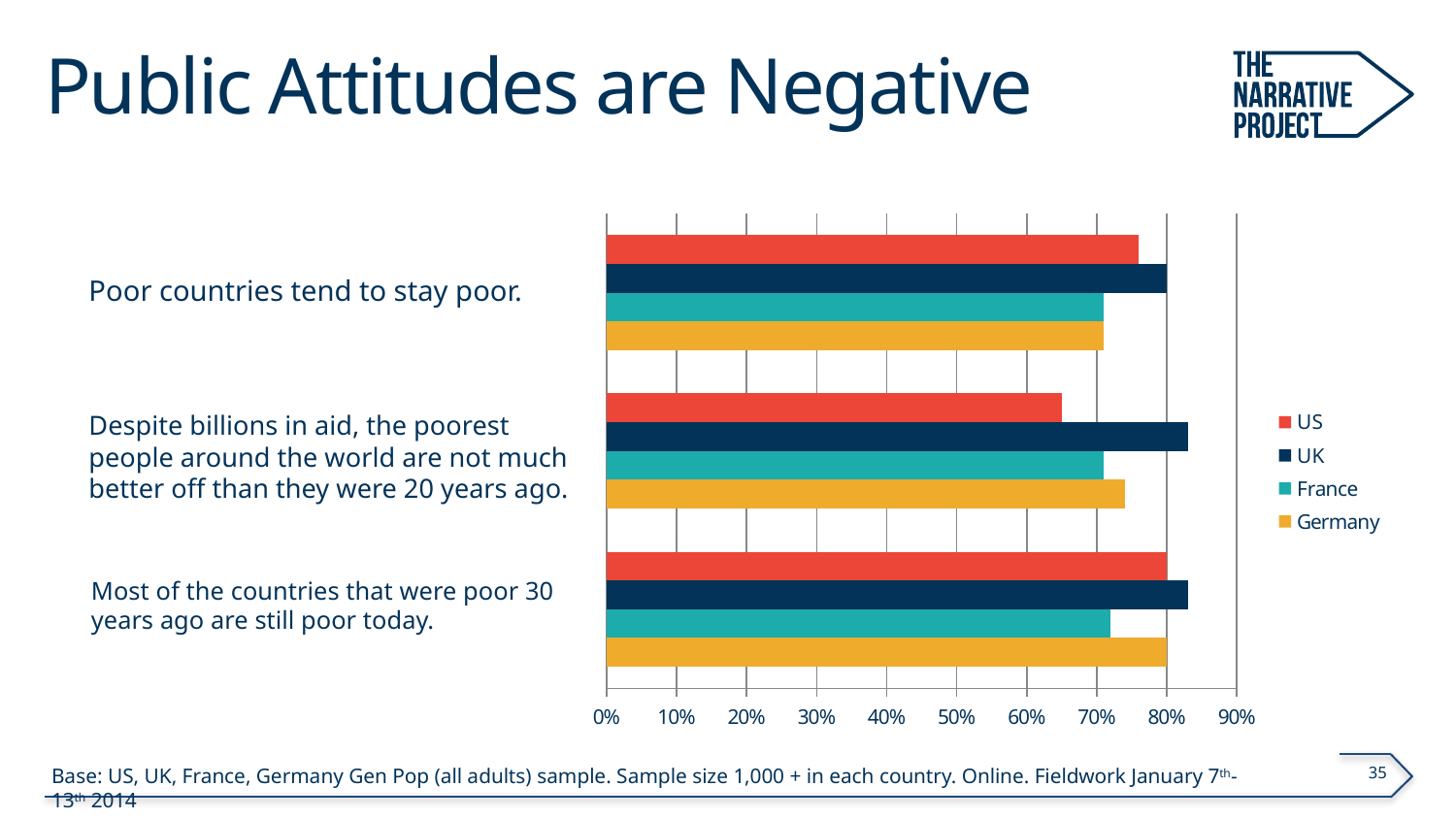
Is the value for the US on "Poor countries tend to stay poor" greater or less than 70%? greater How many series does the legend list? 4 For "Despite billions in aid, the poorest people around the world are not much better off than they were 20 years ago", which country has the lowest value? US How many statements (categories) are plotted in the chart? 3 Is the value for the US on "Despite billions in aid, the poorest people around the world are not much better off than they were 20 years ago" greater or less than 70%? less What kind of chart is shown on the slide? Bar chart Is the value for Germany on "Most of the countries that were poor 30 years ago are still poor today" greater or less than 70%? greater For "Poor countries tend to stay poor", which is larger: the UK value or the France value? UK For "Despite billions in aid, the poorest people around the world are not much better off than they were 20 years ago", which country has the highest value? UK Which colour represents Germany in the legend? Yellow